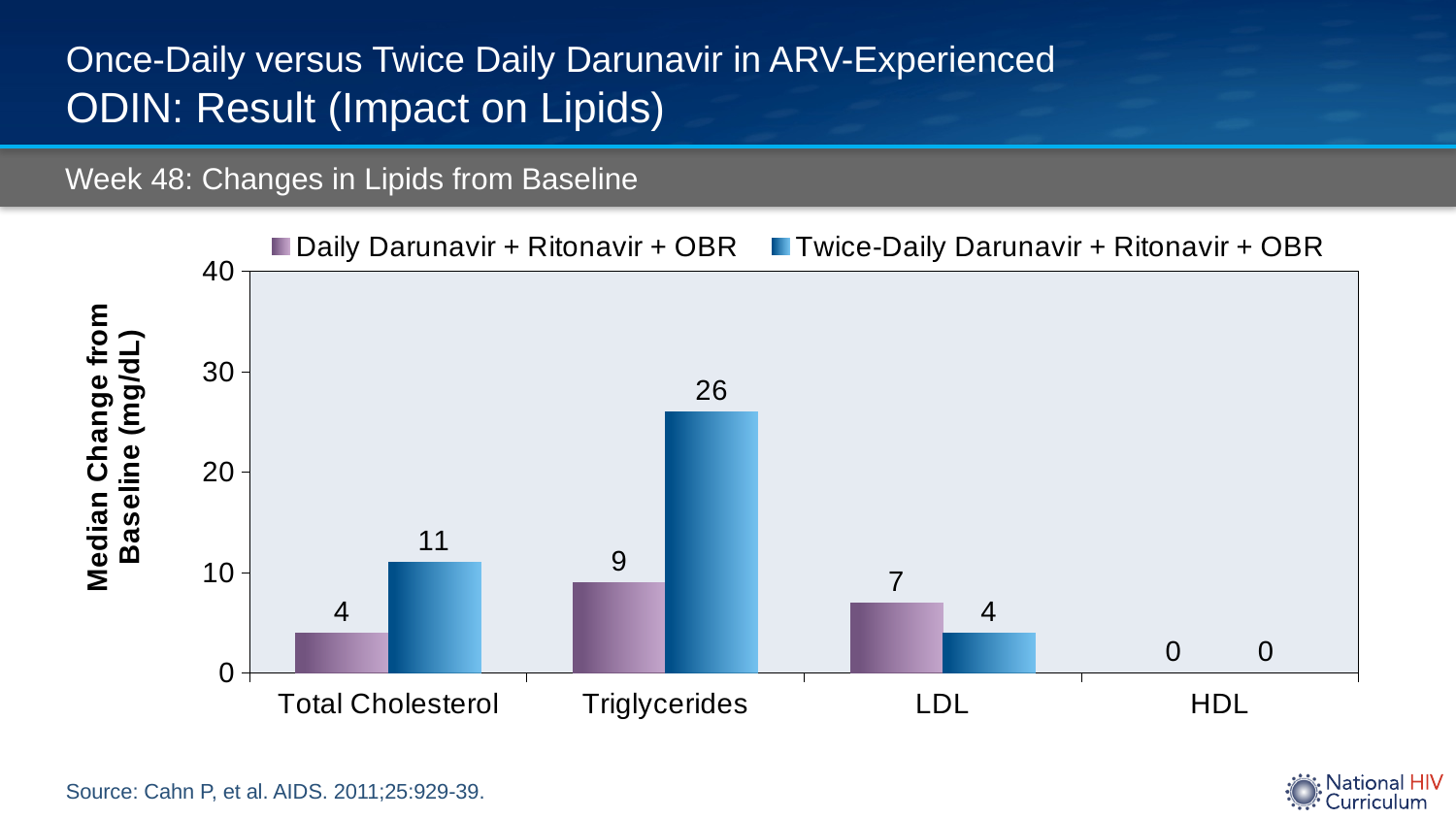
Which lipid category has the highest value for the Twice-Daily Darunavir + Ritonavir + OBR group? Triglycerides What is the median change from baseline in triglycerides for the Twice-Daily Darunavir + Ritonavir + OBR group? 26 What is the median change from baseline in total cholesterol for the Daily Darunavir + Ritonavir + OBR group? 4 What kind of chart is shown on the slide? Bar chart How many lipid categories are shown on the x axis? 4 Is the value for triglycerides in the Twice-Daily Darunavir + Ritonavir + OBR group greater or less than 20? greater What is the difference between the Twice-Daily and Daily Darunavir groups for triglycerides? 17 Which lipid category has the lowest value for the Daily Darunavir + Ritonavir + OBR group? HDL For LDL, which group has the larger median change from baseline? Daily Darunavir + Ritonavir + OBR What is the label of the y axis? Median Change from Baseline (mg/dL) What is the median change from baseline in LDL for the Twice-Daily Darunavir + Ritonavir + OBR group? 4 How many series does the legend list? 2